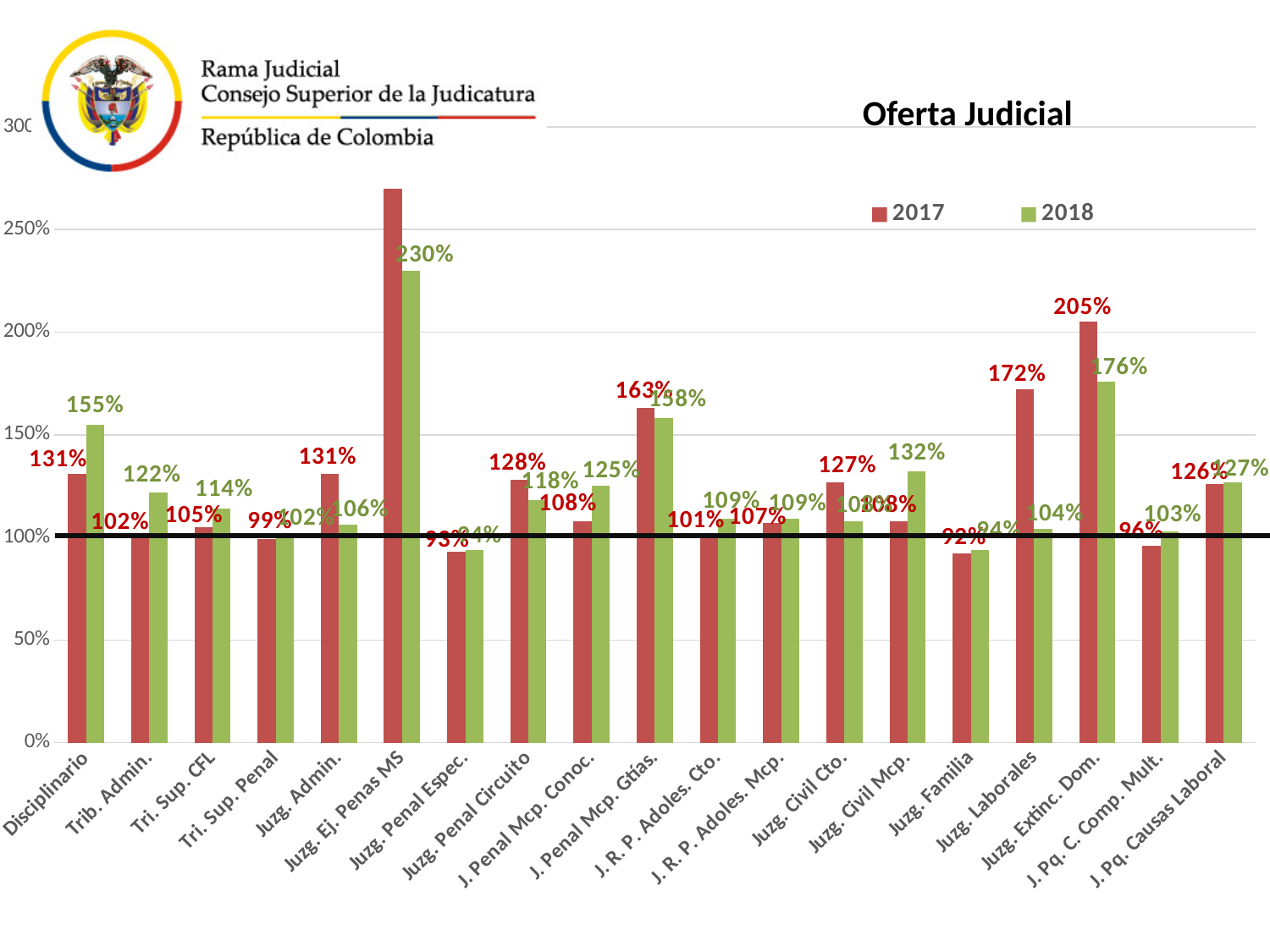
What is the 2018 value for Juzg. Ej. Penas MS? 230% What is the difference between the 2017 and 2018 values for Disciplinario? 24% What is the 2018 value for Disciplinario? 155% Which category has the highest 2018 value? Juzg. Ej. Penas MS Which is larger for Juzg. Extinc. Dom., the 2017 value or the 2018 value? 2017 Is the 2017 value for Juzg. Ej. Penas MS greater or less than 250%? greater What is the 2017 value for Juzg. Laborales? 172% What is the title of the chart? Oferta Judicial What kind of chart is shown on the slide? Bar chart What is the 2017 value for Juzg. Extinc. Dom.? 205% What is the difference between the 2017 and 2018 values for Juzg. Laborales? 68% How many series does the legend list? 2